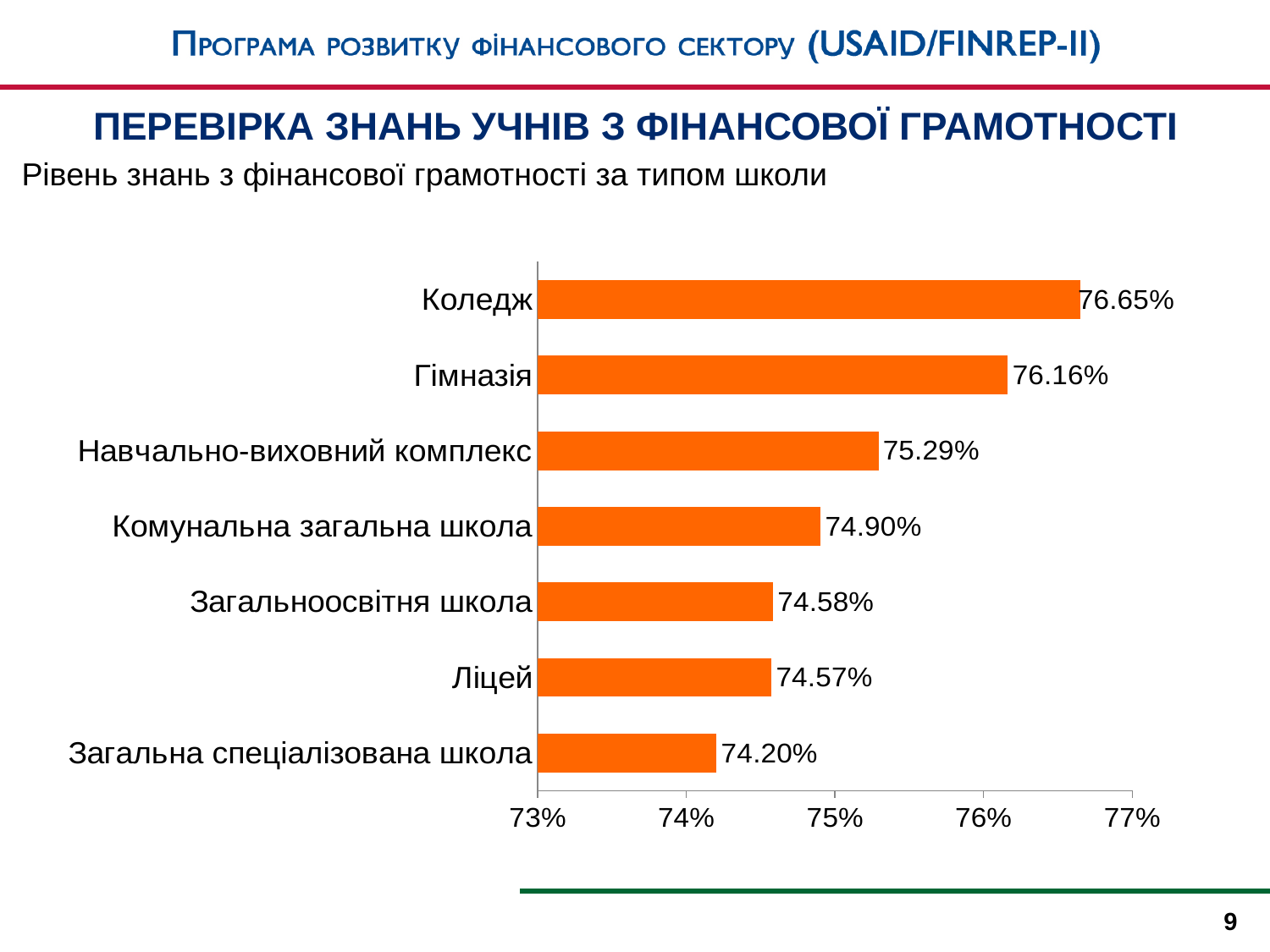
What is the value for Коледж? 76.65% What kind of chart is shown on the slide? bar chart What colour are the bars in the chart? orange Which school type has the lowest value? Загальна спеціалізована школа What is the value for Загальна спеціалізована школа? 74.20% Which school type has the highest value? Коледж How many school types are shown in the chart? 7 Which is larger, the value for Гімназія or the value for Комунальна загальна школа? Гімназія Is the value for Загальноосвітня школа greater or less than 75%? less What is the difference between the values for Коледж and Гімназія? 0.49% What is the difference between the values for Комунальна загальна школа and Загальна спеціалізована школа? 0.70% What is the value for Навчально-виховний комплекс? 75.29%